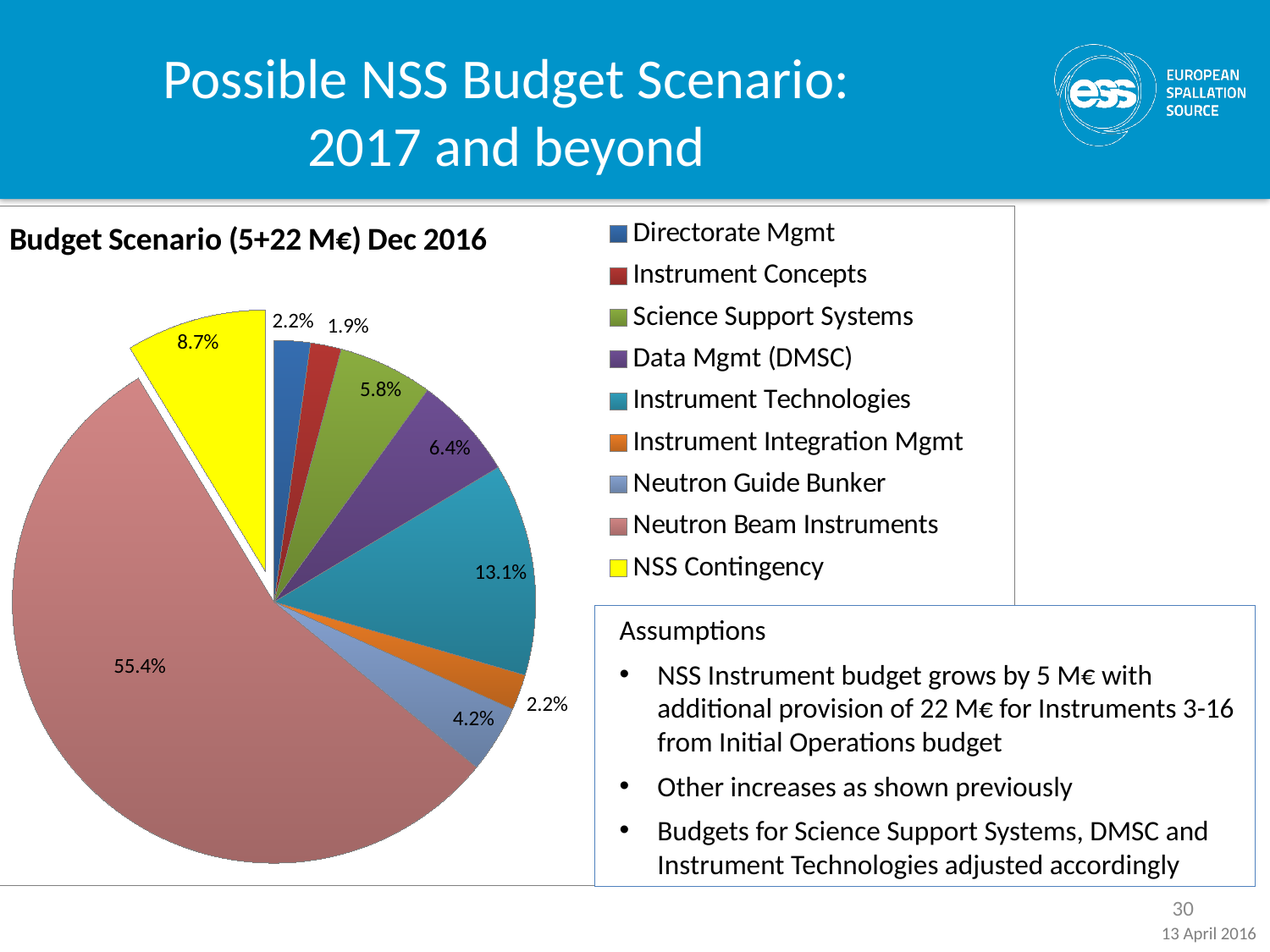
What share of the pie is Instrument Technologies? 13.1% Which category has the smallest slice of the pie? Instrument Concepts What kind of chart is shown on the slide? pie chart What share of the pie is Neutron Guide Bunker? 4.2% How many categories does the legend list? 9 Which is larger, the share for Data Mgmt (DMSC) or the share for Neutron Guide Bunker? Data Mgmt (DMSC) What is the difference between the shares of Instrument Technologies and Science Support Systems? 7.3% Which category has the largest slice of the pie? Neutron Beam Instruments What share of the pie is Data Mgmt (DMSC)? 6.4% What is the title of the chart? Budget Scenario (5+22 M€) Dec 2016